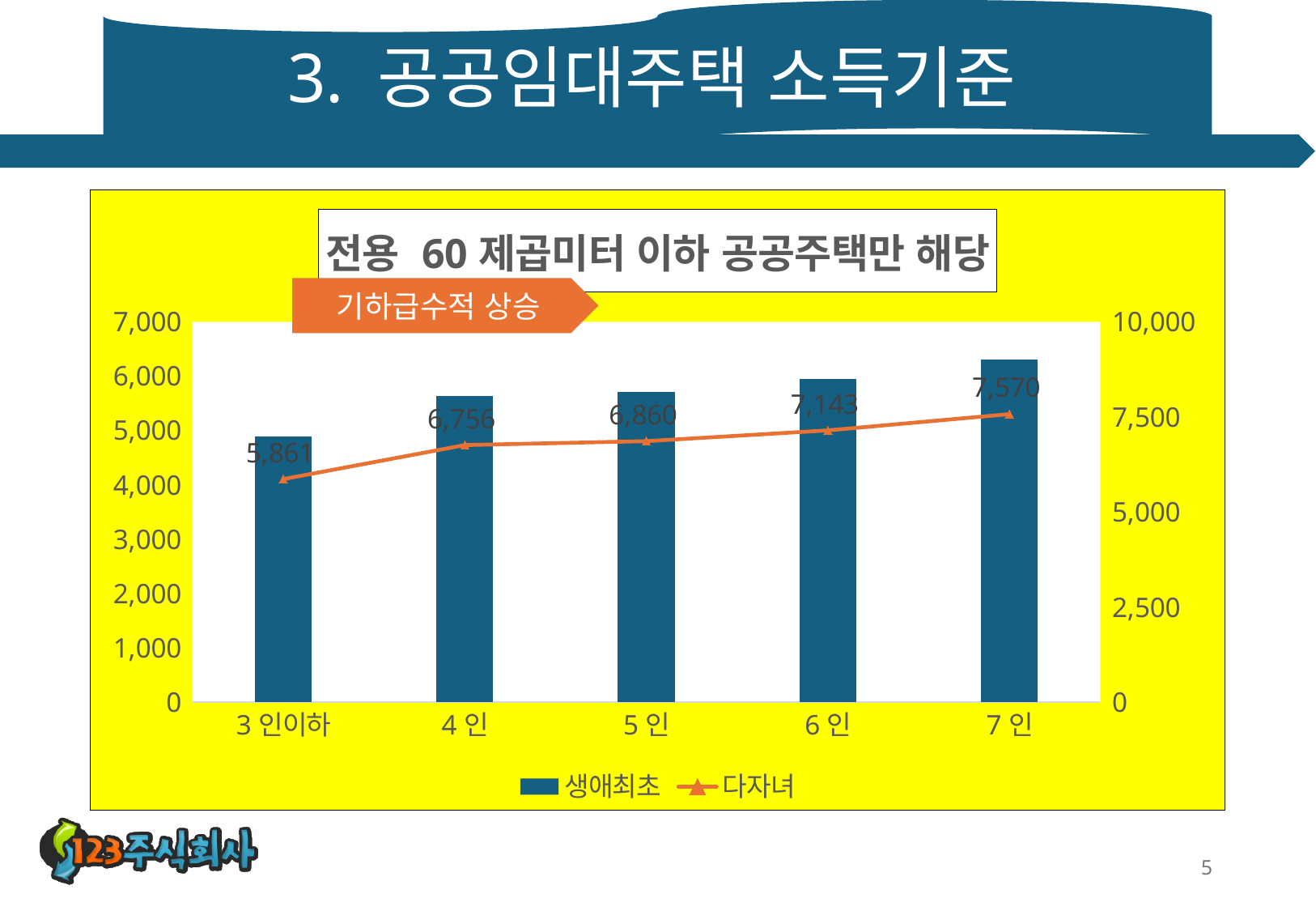
Is the 생애최초 value for 7 인 greater or less than 6,000? greater Which category has the highest 다자녀 value? 7 인 What is the 다자녀 value for 4 인? 6,756 What is the difference between the 다자녀 values for 7 인 and 3 인이하? 1,709 What is the 다자녀 value for 7 인? 7,570 Do the 다자녀 values rise or fall from 3 인이하 to 7 인? rise Which category has the lowest 다자녀 value? 3 인이하 How many series does the legend list? 2 Which is larger, the 다자녀 value for 5 인 or for 4 인? 5 인 How many categories are shown on the x axis? 5 Which category has the tallest 생애최초 bar? 7 인